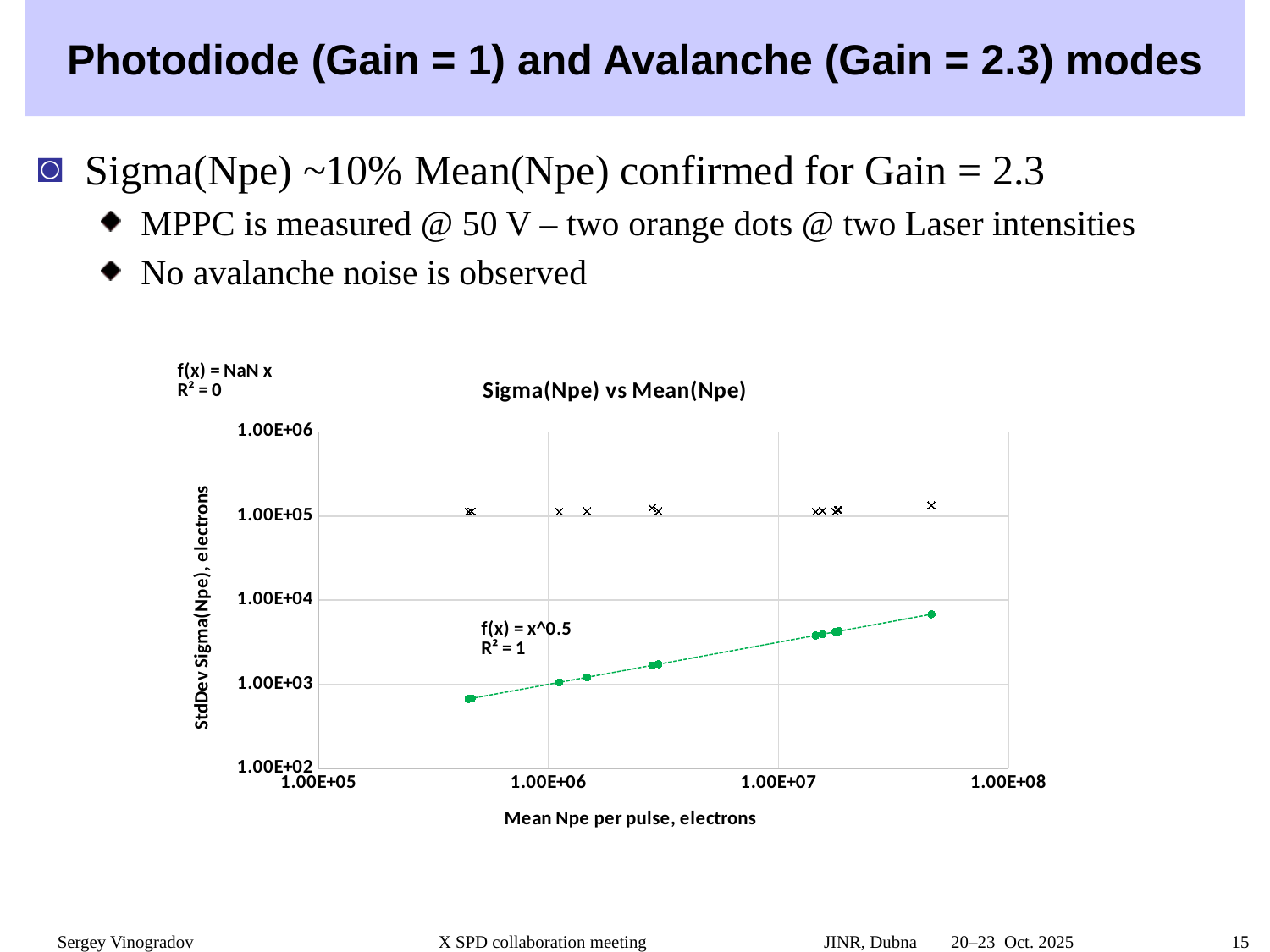
What is the title of the chart? Sigma(Npe) vs Mean(Npe) What is the highest value shown on the y axis of the chart? 1.00E+06 What kind of chart is shown on the slide? scatter chart Is the StdDev value of the leftmost green dot (near 5.00E+05 on the x axis) greater or less than 1.00E+03? less What is the equation of the trendline fitted to the green dots? f(x) = x^0.5 What is the label of the x axis of the chart? Mean Npe per pulse, electrons Are the StdDev values of the black x markers greater or less than 1.00E+04? greater Is the StdDev value of the rightmost green dot (near 5.00E+07 on the x axis) greater or less than 1.00E+04? less Do the green dots rise or fall as Mean Npe per pulse increases along the x axis? rise What R² value is shown for the trendline fitted to the green dots? R² = 1 At a Mean Npe of about 1.00E+06, which series has the larger StdDev value: the black x markers or the green dots? the black x markers